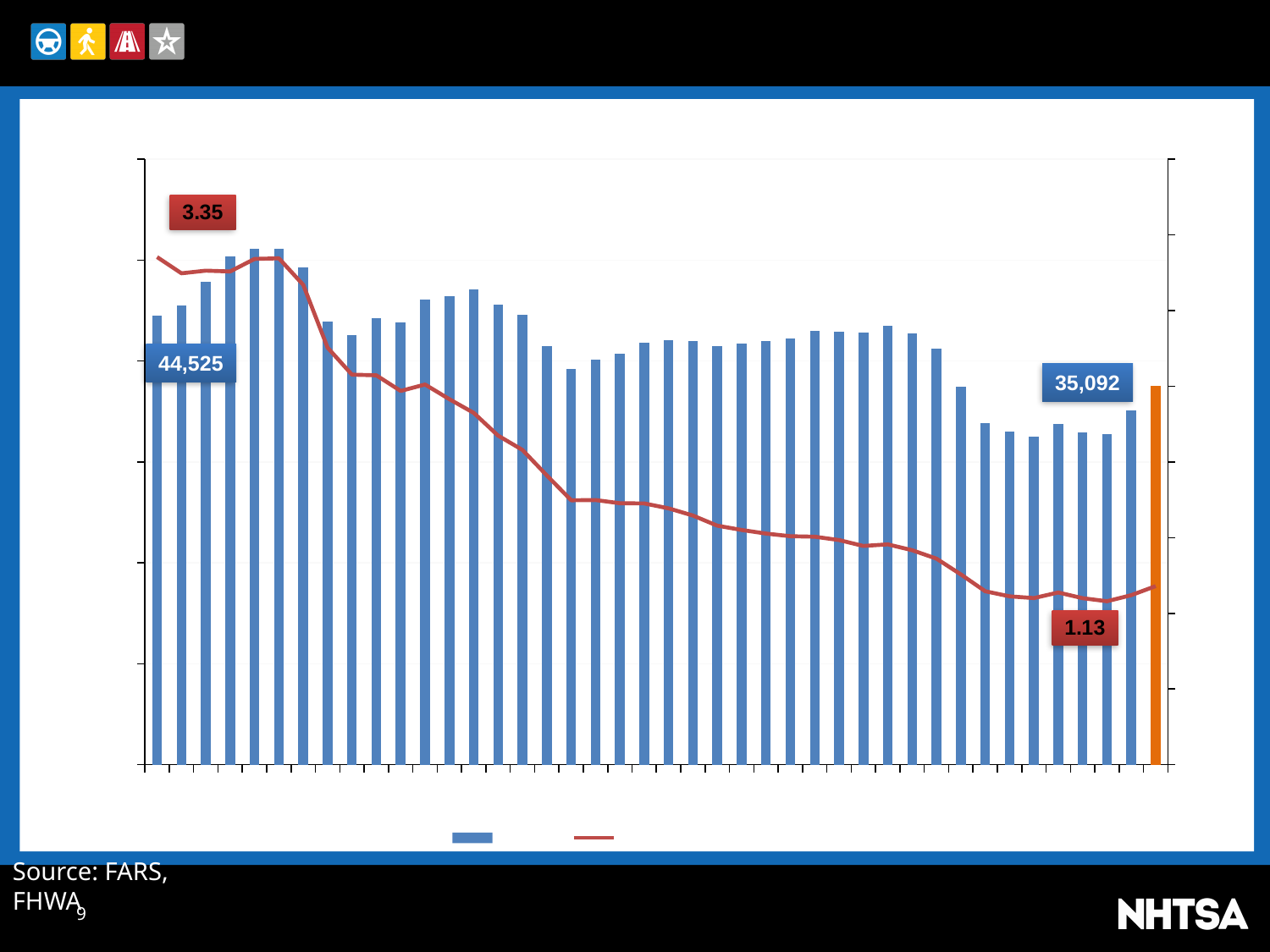
How many series does the legend list? 2 What is the lowest value labelled on the red line? 1.13 Does the red line generally rise or fall from left to right across the chart? Fall Which is larger: the labelled value of the first blue bar or the labelled value of the orange bar? The first blue bar (44,525) What value is labelled on the orange bar at the right end of the chart? 35,092 What colour is the last bar on the right of the chart, which differs from the other bars? Orange What is the difference between the labelled value of the first blue bar (44,525) and the labelled value of the orange bar (35,092)? 9,433 What value is labelled at the start of the red line? 3.35 What value is labelled on the first blue bar at the left of the chart? 44,525 What is the difference between the two labelled values on the red line, 3.35 and 1.13? 2.22 What colour are the bars in the chart apart from the final one? Blue What kind of chart is shown on the slide? A bar chart combined with a line chart